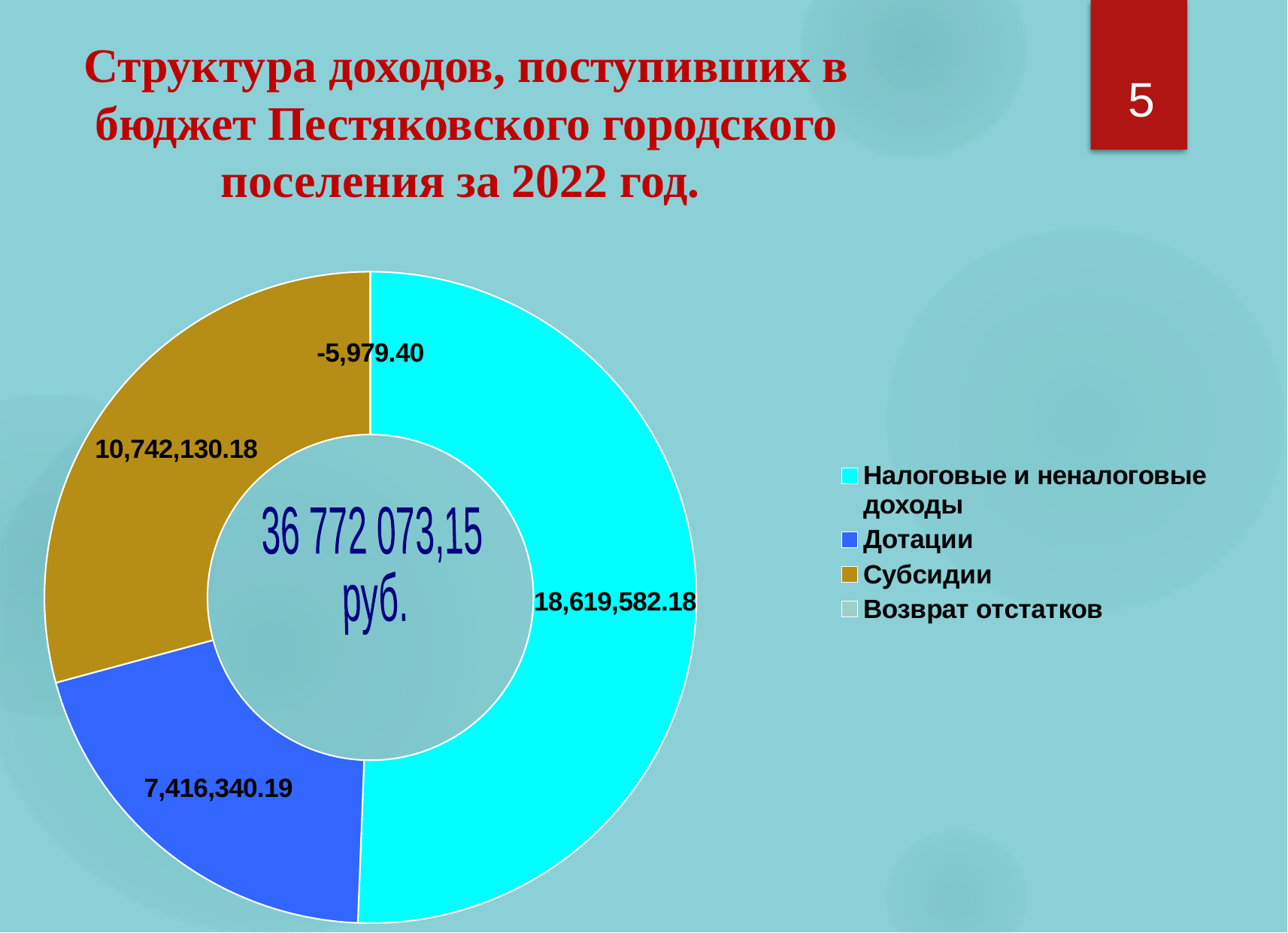
What is the value shown for Налоговые и неналоговые доходы? 18,619,582.18 Which is larger, the value for Субсидии or the value for Дотации? Субсидии What total amount is written in the centre of the chart? 36 772 073,15 руб. Which category has the smallest value? Возврат отстатков What is the value shown for Субсидии? 10,742,130.18 What is the value shown for Возврат отстатков? -5,979.40 What kind of chart is shown on the slide? doughnut chart What is the difference between the values for Субсидии and Дотации? 3,325,789.99 Which category has the largest value? Налоговые и неналоговые доходы What is the value shown for Дотации? 7,416,340.19 What is the difference between the values for Налоговые и неналоговые доходы and Субсидии? 7,877,452.00 How many categories does the legend list? 4